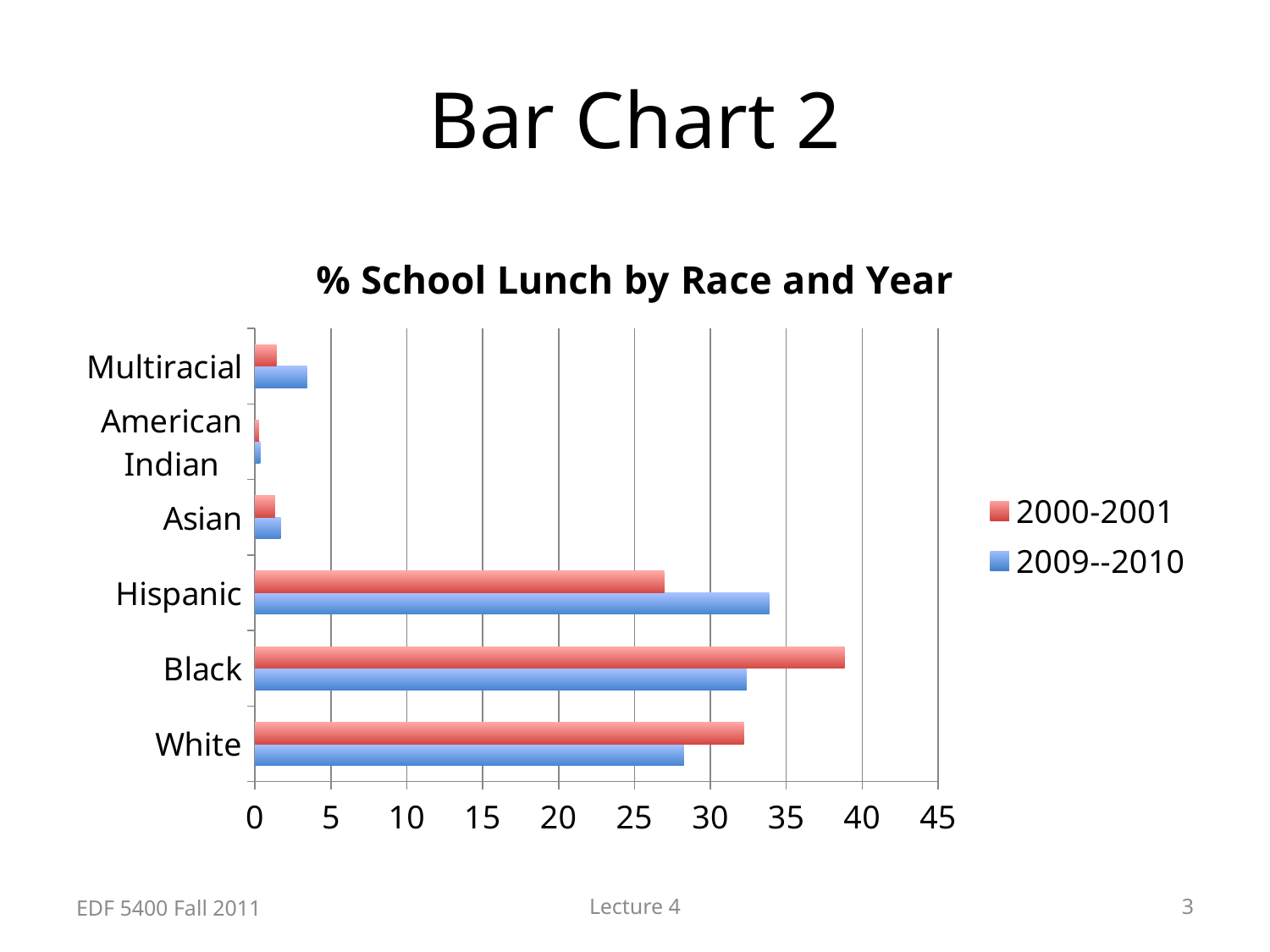
How many series does the legend list? 2 What is the title of the chart? % School Lunch by Race and Year Which race category has the highest value for 2000-2001? Black Is the value for Black in 2000-2001 greater or less than 35? greater Which race category has the highest value for 2009--2010? Hispanic Is the value for White in 2009--2010 greater or less than 30? less For White, which year has the larger value, 2000-2001 or 2009--2010? 2000-2001 Which colour represents the 2009--2010 series? Blue How many race categories are shown on the chart? 6 What kind of chart is shown on the slide? Bar chart Which race category has the lowest value for 2000-2001? American Indian For Hispanic, which year has the larger value, 2000-2001 or 2009--2010? 2009--2010